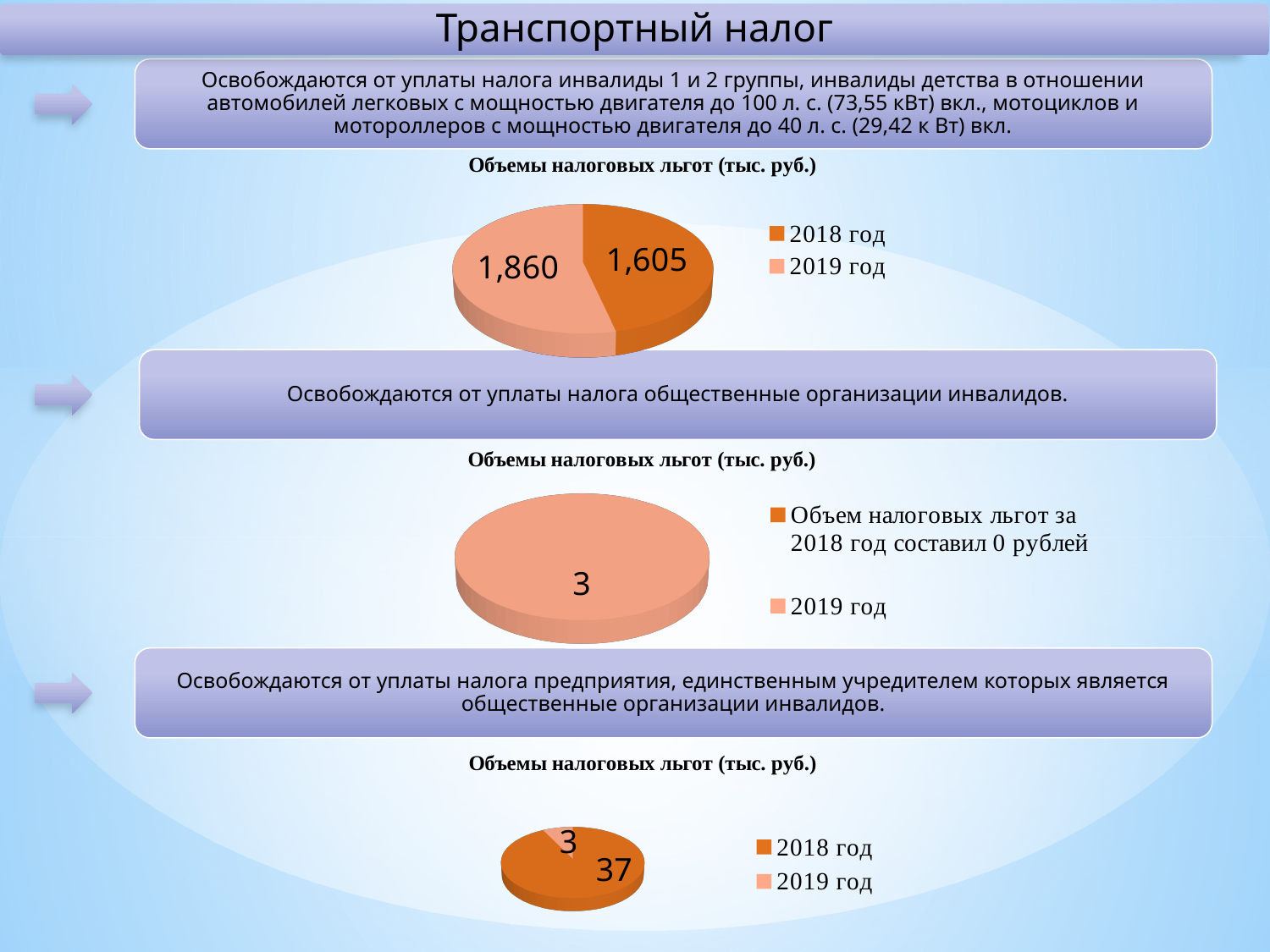
In the bottom pie chart, what is the value for 2018 год? 37 In the bottom pie chart, what is the value for 2019 год? 3 How many series does the legend of the top pie chart list? 2 What kind of chart is the top chart on the slide? Pie chart In the top pie chart, what is the value for 2018 год? 1,605 In the bottom pie chart, which year has the smaller value? 2019 год In the middle pie chart, what is the value for 2019 год? 3 In the top pie chart, which year has the larger value? 2019 год In the middle pie chart, what does the legend say the volume of tax benefits for 2018 was? 0 рублей In the top pie chart, what is the value for 2019 год? 1,860 In the bottom pie chart, what is the difference between the 2018 год and 2019 год values? 34 In the top pie chart, what is the difference between the 2019 год and 2018 год values? 255